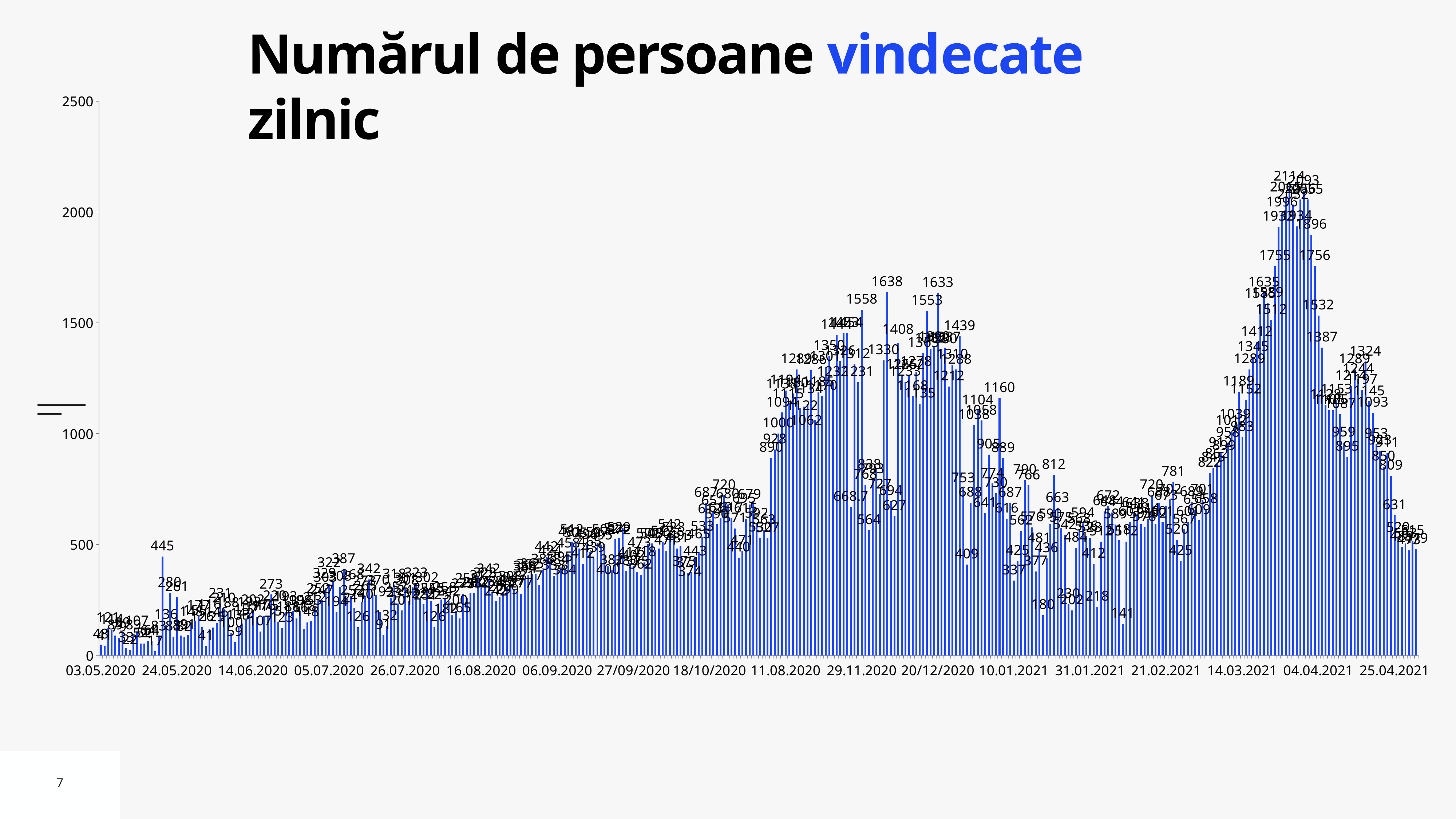
What is the difference between the overall peak value of 2114 and the late-November 2020 peak of 1638? 476 Is the value for 31.01.2021 greater or less than 500? greater What kind of chart is shown on the slide? bar chart Is the value for 04.04.2021 greater or less than 1500? greater Do the values generally rise or fall between 06.09.2020 and 29.11.2020? rise Do the values rise or fall between 04.04.2021 and 25.04.2021? fall Which is larger, the peak labelled 2114 or the bar labelled 1896? 2114 What is the highest value labelled on the chart? 2114 What is the highest tick value shown on the vertical axis? 2500 Is the value for 03.05.2020 greater or less than 500? less What is the value of the tallest bar in the May 2020 spike, near 24.05.2020? 445 What is the title of the chart? Numărul de persoane vindecate zilnic